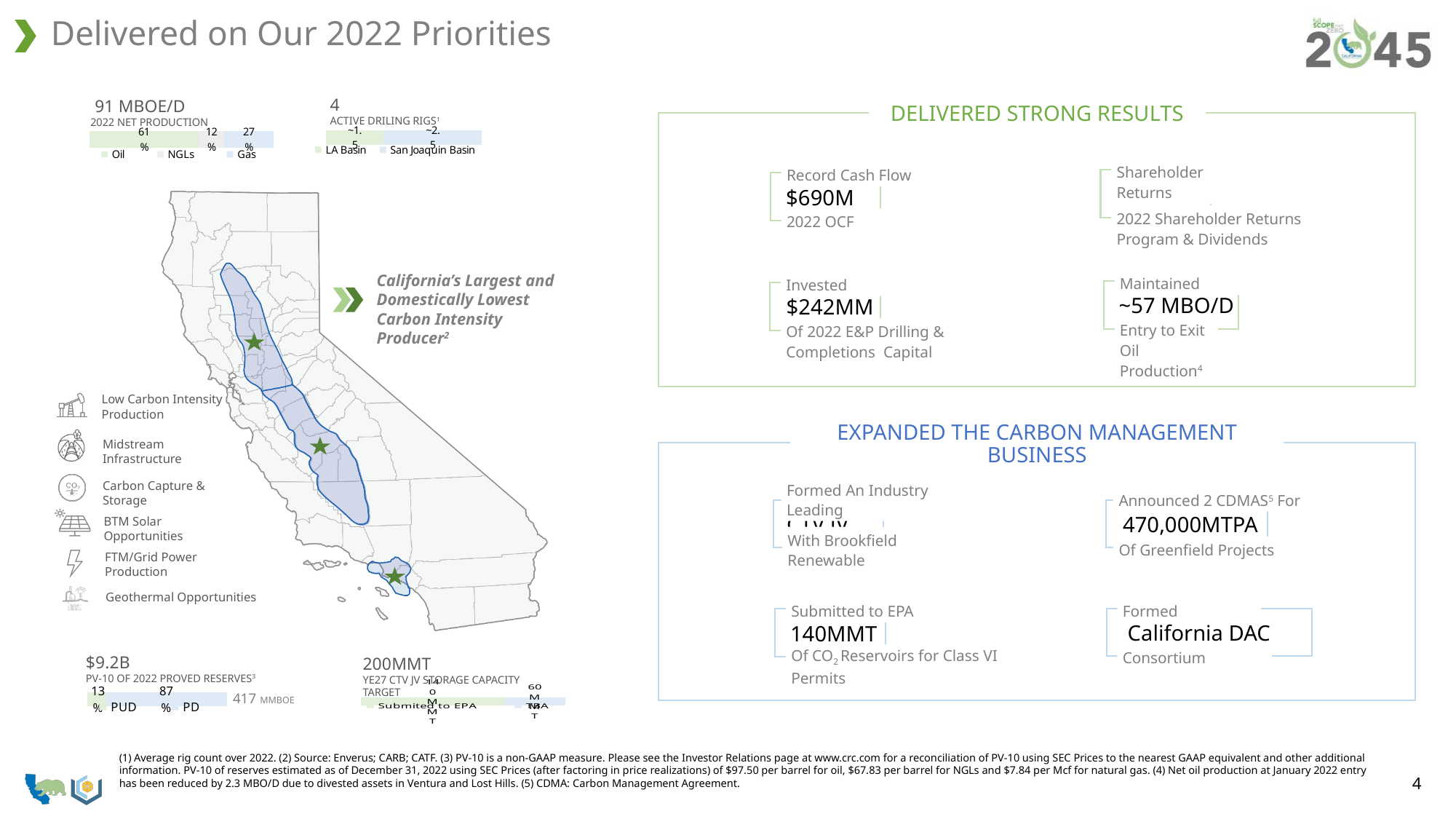
In the 2022 Net Production chart, which product has the smallest share? NGLs In the PV-10 of 2022 Proved Reserves chart, what percentage is PD? 87% In the PV-10 of 2022 Proved Reserves chart, what percentage is PUD? 13% In the 2022 Net Production chart, which product has the largest share? Oil In the YE27 CTV JV Storage Capacity Target chart, what is the value for Submitted to EPA? 140 MMT In the 2022 Net Production chart, what percentage is Oil? 61% What kind of chart is the 2022 Net Production chart? bar chart In the 2022 Net Production chart, what percentage is Gas? 27% In the 2022 Net Production chart, how many percentage points larger is Oil than Gas? 34 In the 2022 Net Production chart, what percentage is NGLs? 12% How many series does the legend of the 2022 Net Production chart list? 3 In the Active Drilling Rigs chart, which basin has more rigs, LA Basin or San Joaquin Basin? San Joaquin Basin